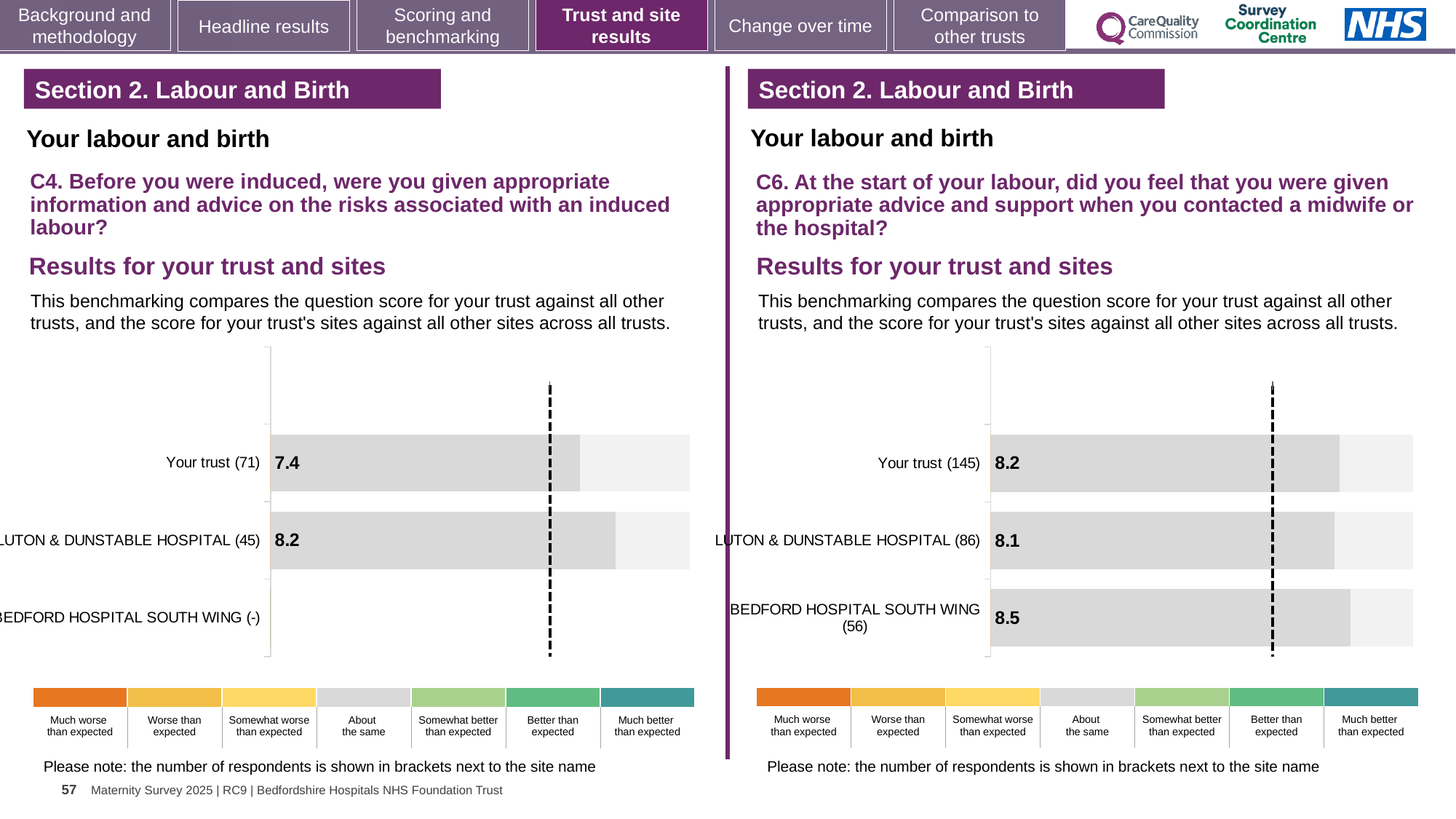
In the C4 chart on the left, what is the difference between the scores for Luton & Dunstable Hospital (45) and Your trust (71)? 0.8 In the C6 chart on the right, which site or trust has the highest score? Bedford Hospital South Wing (56) In the C6 chart on the right, what is the difference between the scores for Bedford Hospital South Wing (56) and Your trust (145)? 0.3 In the C6 chart on the right, what is the score for Your trust (145)? 8.2 In the C6 chart on the right, which site or trust has the lowest score? Luton & Dunstable Hospital (86) In the C4 chart on the left, which has the higher score: Your trust (71) or Luton & Dunstable Hospital (45)? Luton & Dunstable Hospital (45) In the C4 chart on the left, how many respondents are shown in brackets for Your trust? 71 In the C6 chart on the right, what is the score for Bedford Hospital South Wing (56)? 8.5 In the C4 chart on the left, what is the score for Your trust (71)? 7.4 In the C4 chart on the left, what is the score for Luton & Dunstable Hospital (45)? 8.2 What type of chart is used on the left for question C4? Bar chart How many categories (trust and sites) are listed on the C6 chart on the right? 3